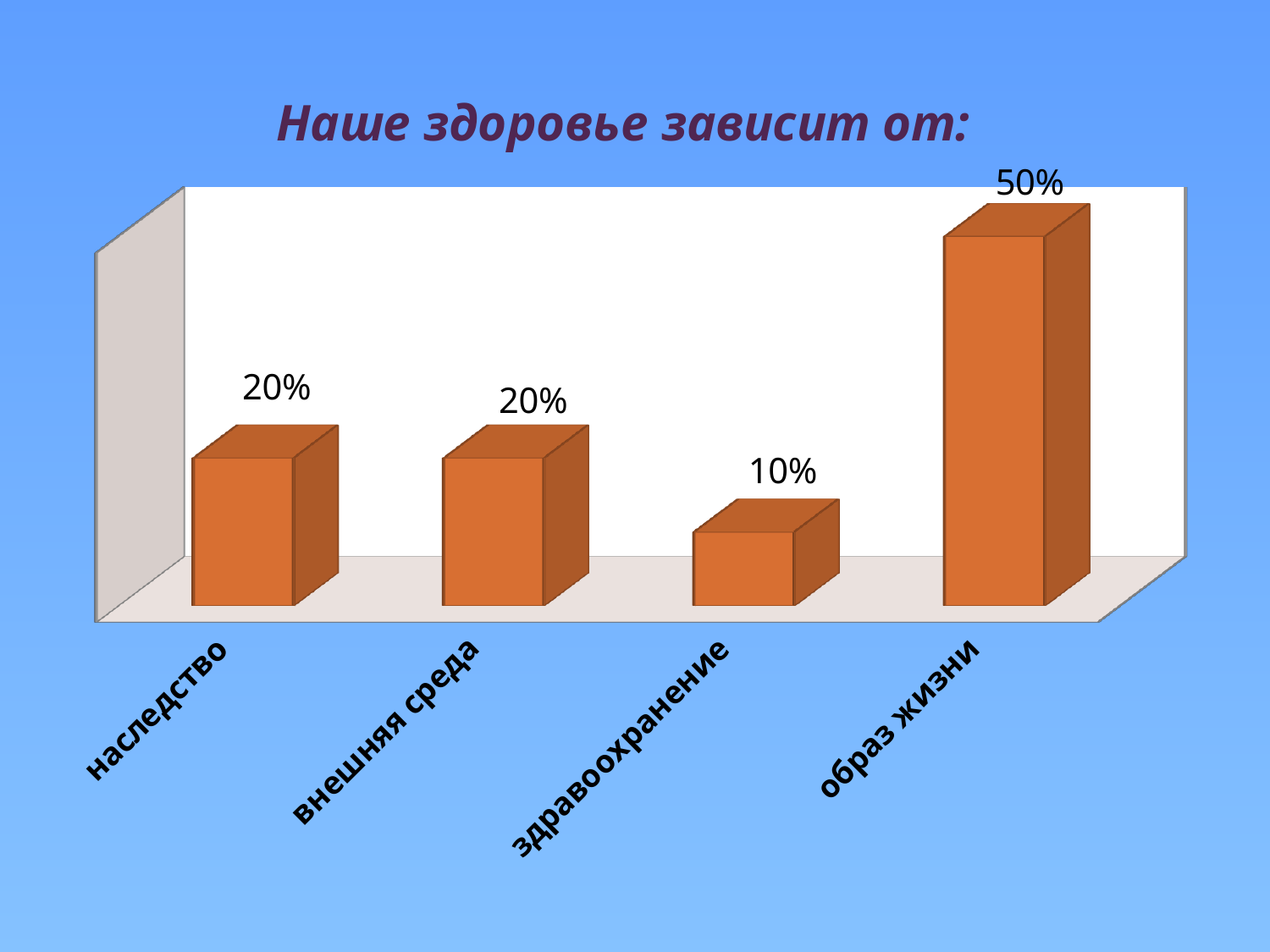
What kind of chart is shown on the slide? bar chart What is the value for здравоохранение? 10% What is the value for наследство? 20% Which is larger, the value for образ жизни or the value for внешняя среда? образ жизни What is the value for внешняя среда? 20% How many categories are shown in the chart? 4 What is the difference between the values for образ жизни and здравоохранение? 40% Which category has the lowest value? здравоохранение What is the difference between the values for наследство and здравоохранение? 10% What is the title of the slide? Наше здоровье зависит от: Which category has the highest value? образ жизни What is the value for образ жизни? 50%